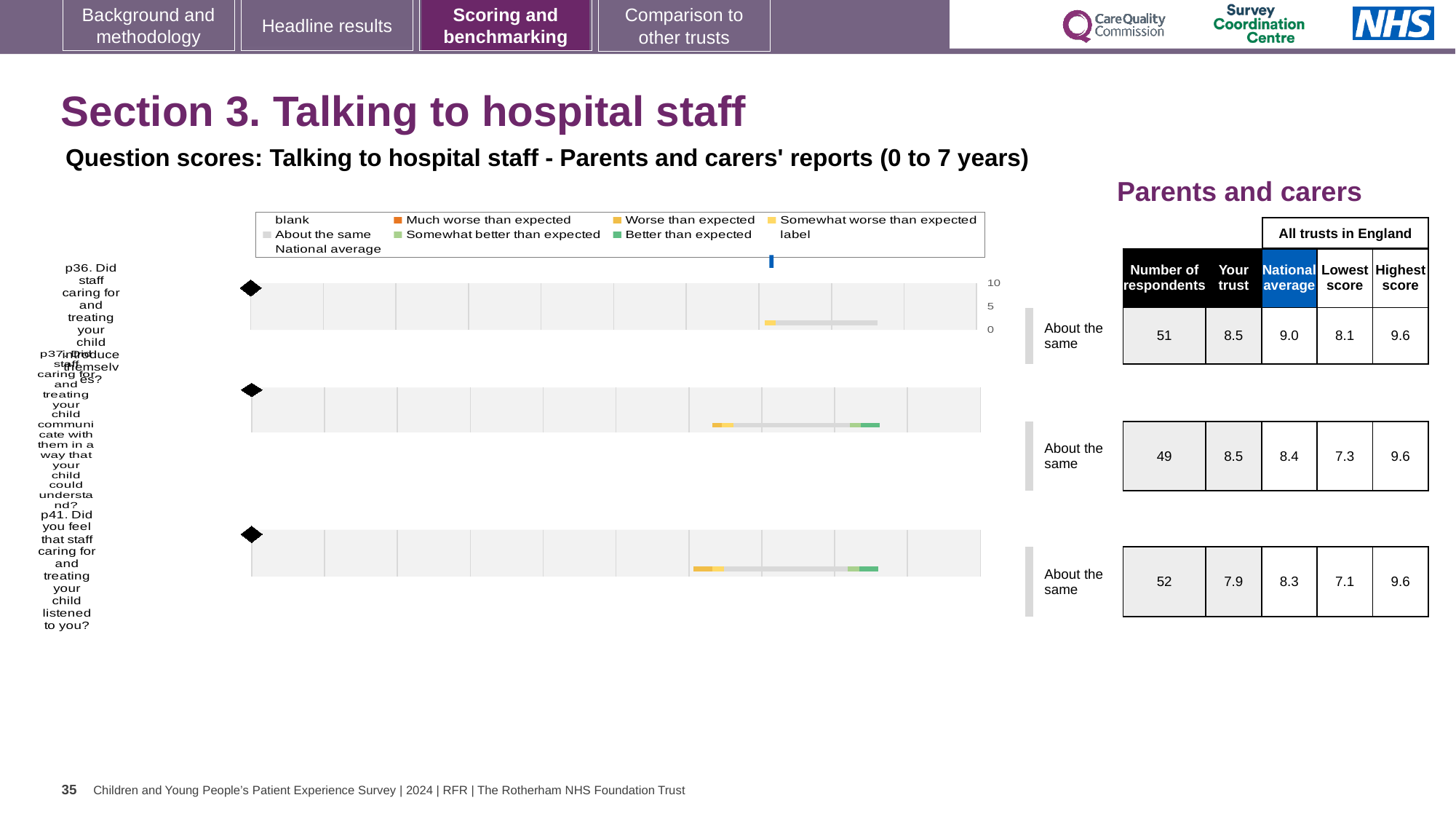
What is the difference between the national average and the 'Your trust' score for p36? 0.5 For p37, which is larger: the 'Your trust' score or the national average? Your trust What is the 'Your trust' score for p36 (Did staff caring for and treating your child introduce themselves)? 8.5 What heading appears above the results table on the right of the slide? Parents and carers What is the lowest score among all trusts in England for p41? 7.1 How many respondents answered p37 (Did staff communicate with your child in a way they could understand)? 49 What is the highest score among all trusts in England for p36? 9.6 What is the national average score for p41 (Did you feel that staff caring for and treating your child listened to you)? 8.3 Which question has the lowest 'Your trust' score? p41 What kind of chart is used to show the question scores on this slide? bar chart What benchmark category is shown next to each of the three questions? About the same How many survey questions (p36, p37, p41) are plotted on the slide? 3